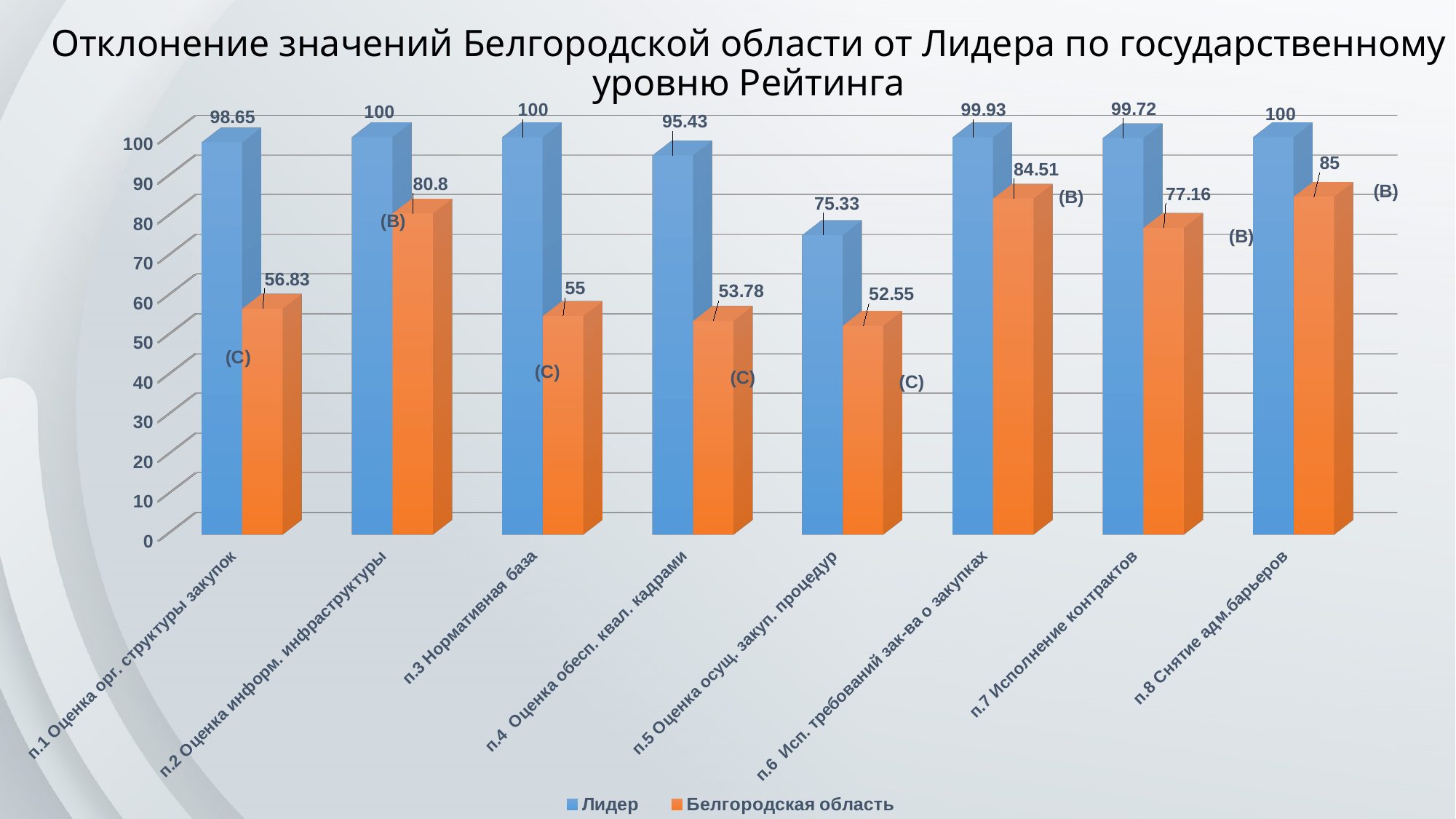
Which category has the lowest value for Белгородская область? п.5 Оценка осущ. закуп. процедур Which category has the highest value for Белгородская область? п.8 Снятие адм.барьеров Which category has the lowest value for Лидер? п.5 Оценка осущ. закуп. процедур What is the difference between Лидер and Белгородская область in category п.6 Исп. требований зак-ва о закупках? 15.42 What is the value for Белгородская область in category п.1 Оценка орг. структуры закупок? 56.83 What kind of chart is shown on the slide? Bar chart What is the value for Белгородская область in category п.7 Исполнение контрактов? 77.16 How many categories are shown on the x axis? 8 Which is larger for Белгородская область: п.2 Оценка информ. инфраструктуры or п.4 Оценка обесп. квал. кадрами? п.2 Оценка информ. инфраструктуры How many series does the legend list? 2 What is the difference between Лидер and Белгородская область in category п.3 Нормативная база? 45 What is the value for Лидер in category п.5 Оценка осущ. закуп. процедур? 75.33